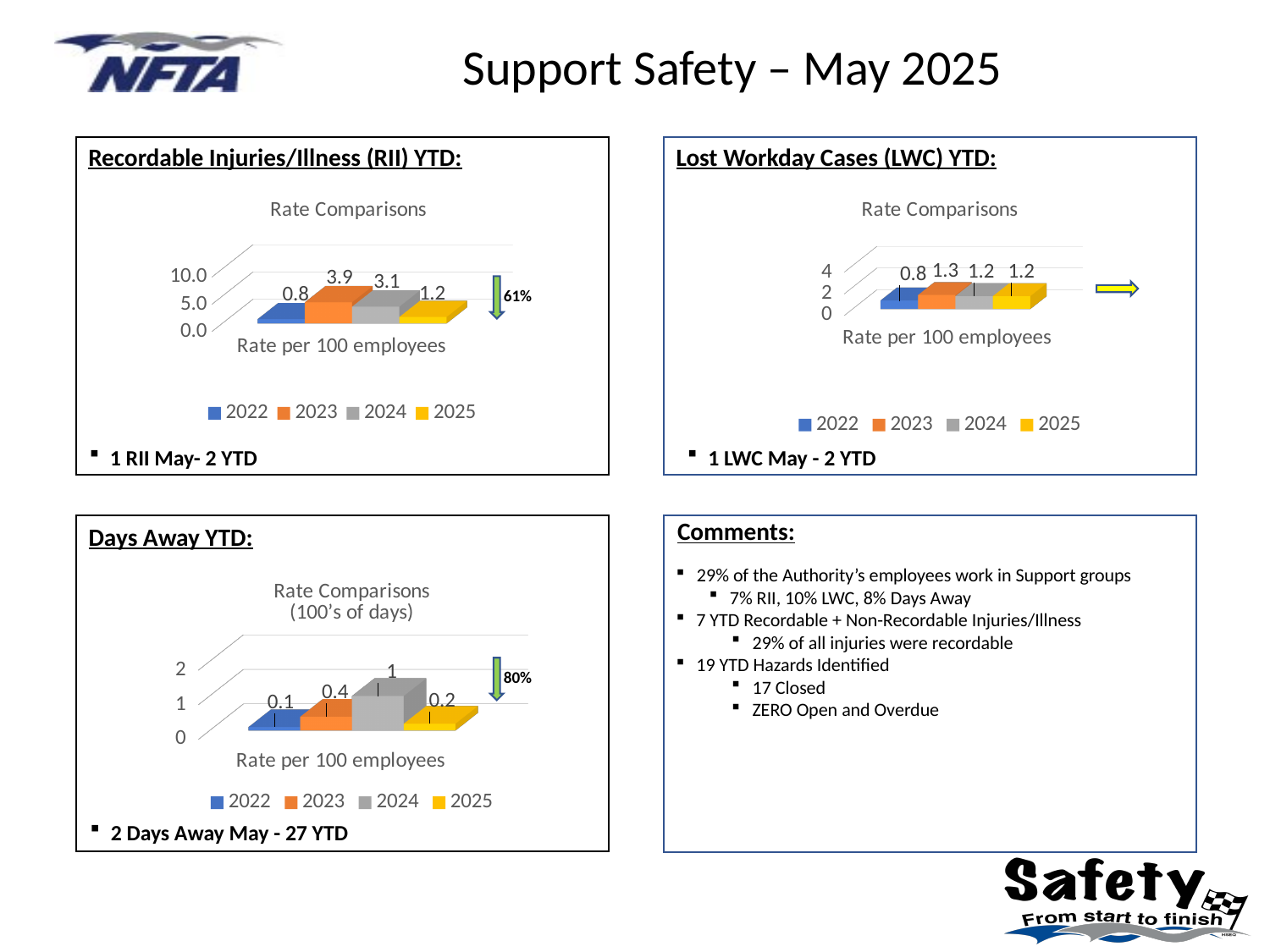
In the Recordable Injuries/Illness (RII) YTD chart, what is the rate per 100 employees for 2023? 3.9 In the Recordable Injuries/Illness (RII) YTD chart, is the 2024 rate greater or less than 5.0? less In the Days Away YTD chart, is the 2023 rate larger or smaller than the 2025 rate? larger In the Recordable Injuries/Illness (RII) YTD chart, what is the difference between the 2023 and 2025 rates? 2.7 In the Lost Workday Cases (LWC) YTD chart, how many series does the legend list? 4 What kind of chart is the Days Away YTD chart? bar chart In the Days Away YTD chart, what is the rate per 100 employees for 2024? 1 In the Lost Workday Cases (LWC) YTD chart, which year has the highest rate? 2023 In the Days Away YTD chart, which year has the highest rate? 2024 In the Lost Workday Cases (LWC) YTD chart, what is the rate per 100 employees for 2023? 1.3 What is the title of the Days Away YTD chart? Rate Comparisons (100's of days) In the Recordable Injuries/Illness (RII) YTD chart, which year has the lowest rate? 2022